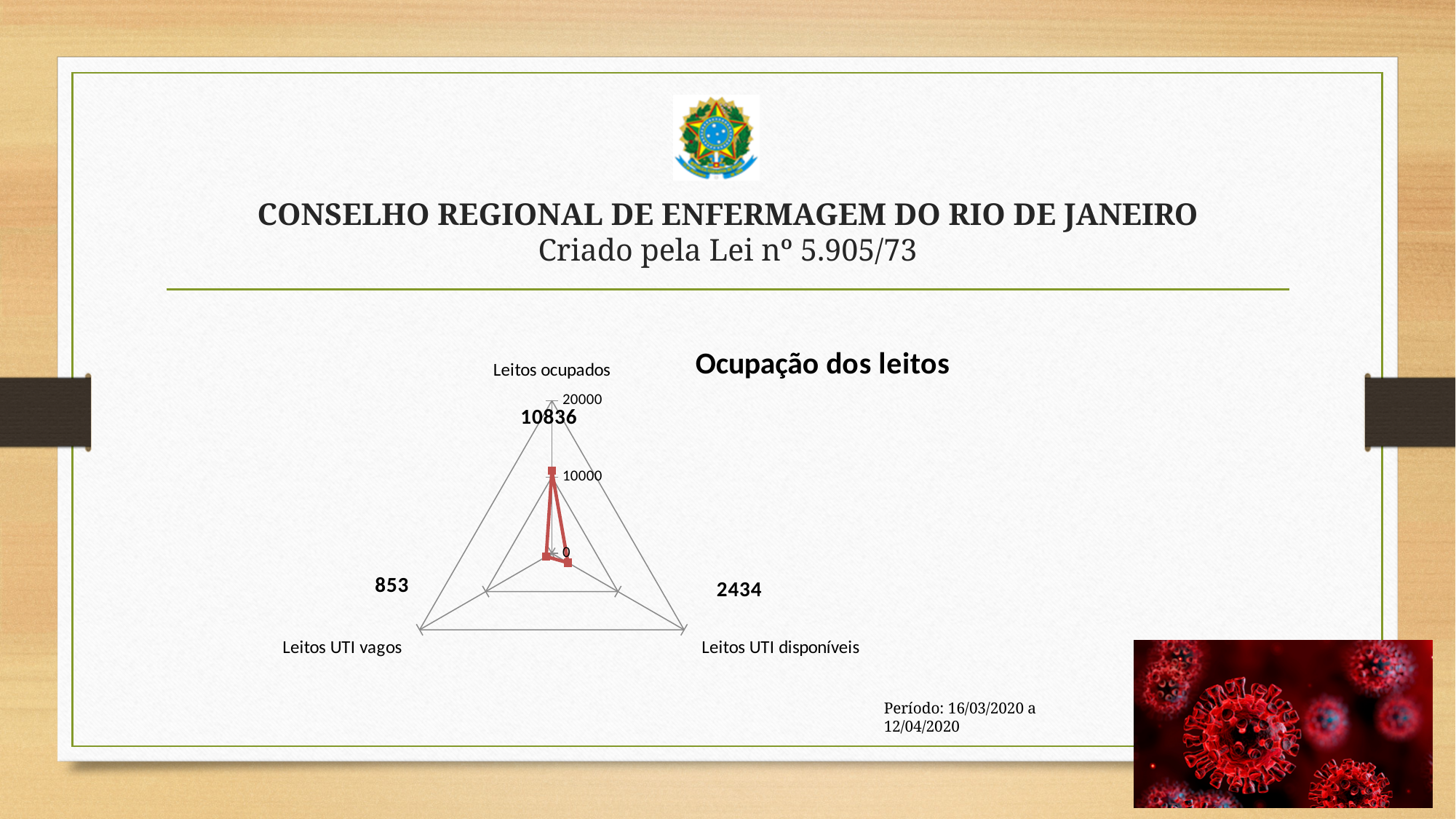
Which category has the highest value in the Ocupação dos leitos chart? Leitos ocupados Which is larger in the Ocupação dos leitos chart, Leitos UTI disponíveis or Leitos UTI vagos? Leitos UTI disponíveis What is the difference between Leitos ocupados and Leitos UTI disponíveis in the Ocupação dos leitos chart? 8402 What is the difference between Leitos UTI disponíveis and Leitos UTI vagos in the Ocupação dos leitos chart? 1581 What is the title of the chart on the slide? Ocupação dos leitos Which category has the lowest value in the Ocupação dos leitos chart? Leitos UTI vagos What is the value for Leitos UTI disponíveis in the Ocupação dos leitos chart? 2434 Is the value for Leitos ocupados greater or less than 10000 in the Ocupação dos leitos chart? greater What is the value for Leitos ocupados in the Ocupação dos leitos chart? 10836 What is the value for Leitos UTI vagos in the Ocupação dos leitos chart? 853 How many categories are plotted in the Ocupação dos leitos chart? 3 What kind of chart is the Ocupação dos leitos chart? Radar chart